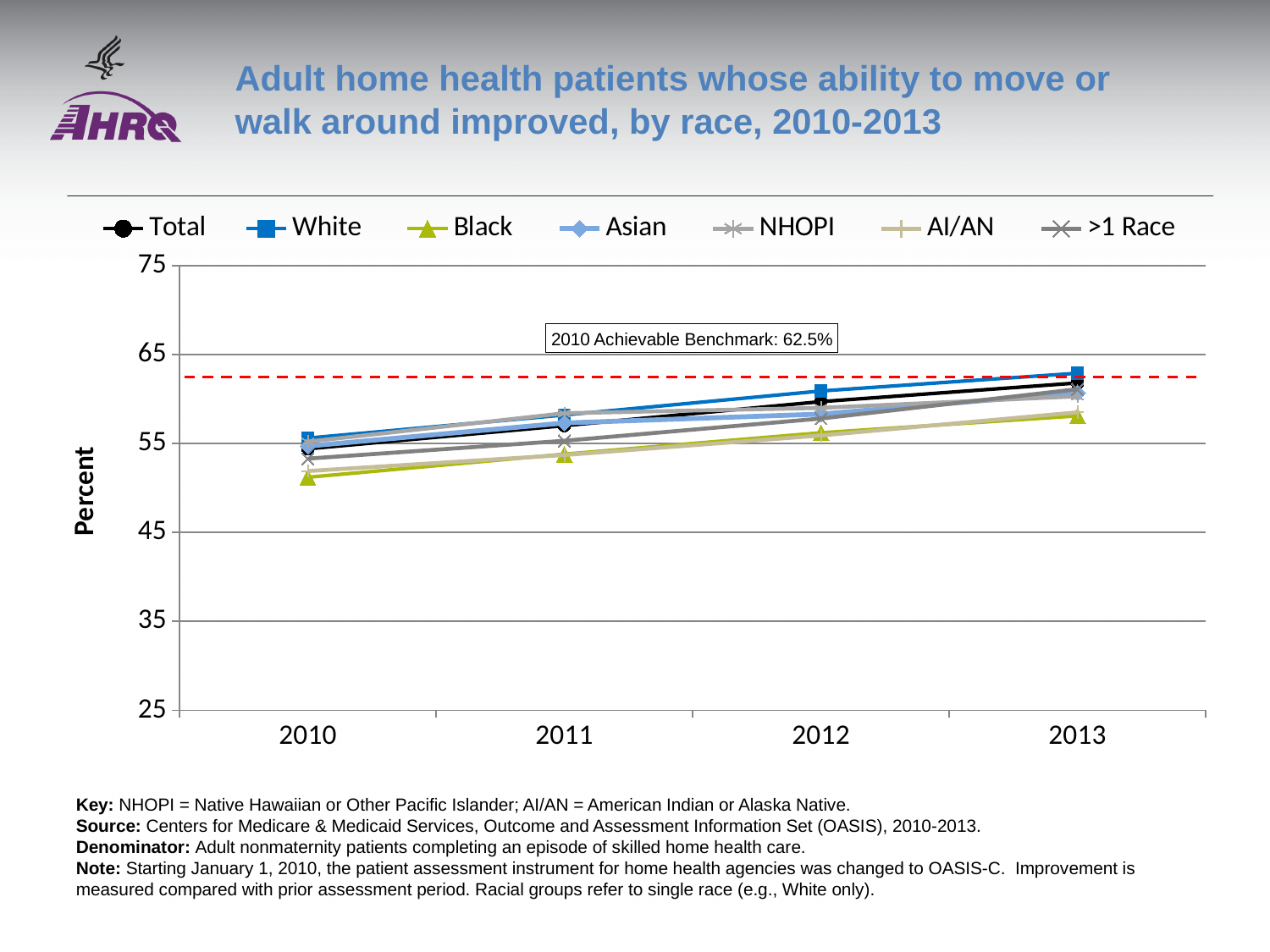
Is the value for White in 2012 greater or less than 55? greater Which is larger in 2010, the value for White or the value for Black? White Is the value for Black in 2013 greater or less than 65? less How many years are plotted along the x axis? 4 Does the value for Total rise or fall from 2010 to 2013? rise How many series does the legend list? 7 Is the value for Total in 2013 greater or less than 55? greater What kind of chart is shown on the slide? line chart What is the label on the y axis? Percent Does the value for Black rise or fall from 2010 to 2013? rise What is the 2010 Achievable Benchmark shown on the chart? 62.5%